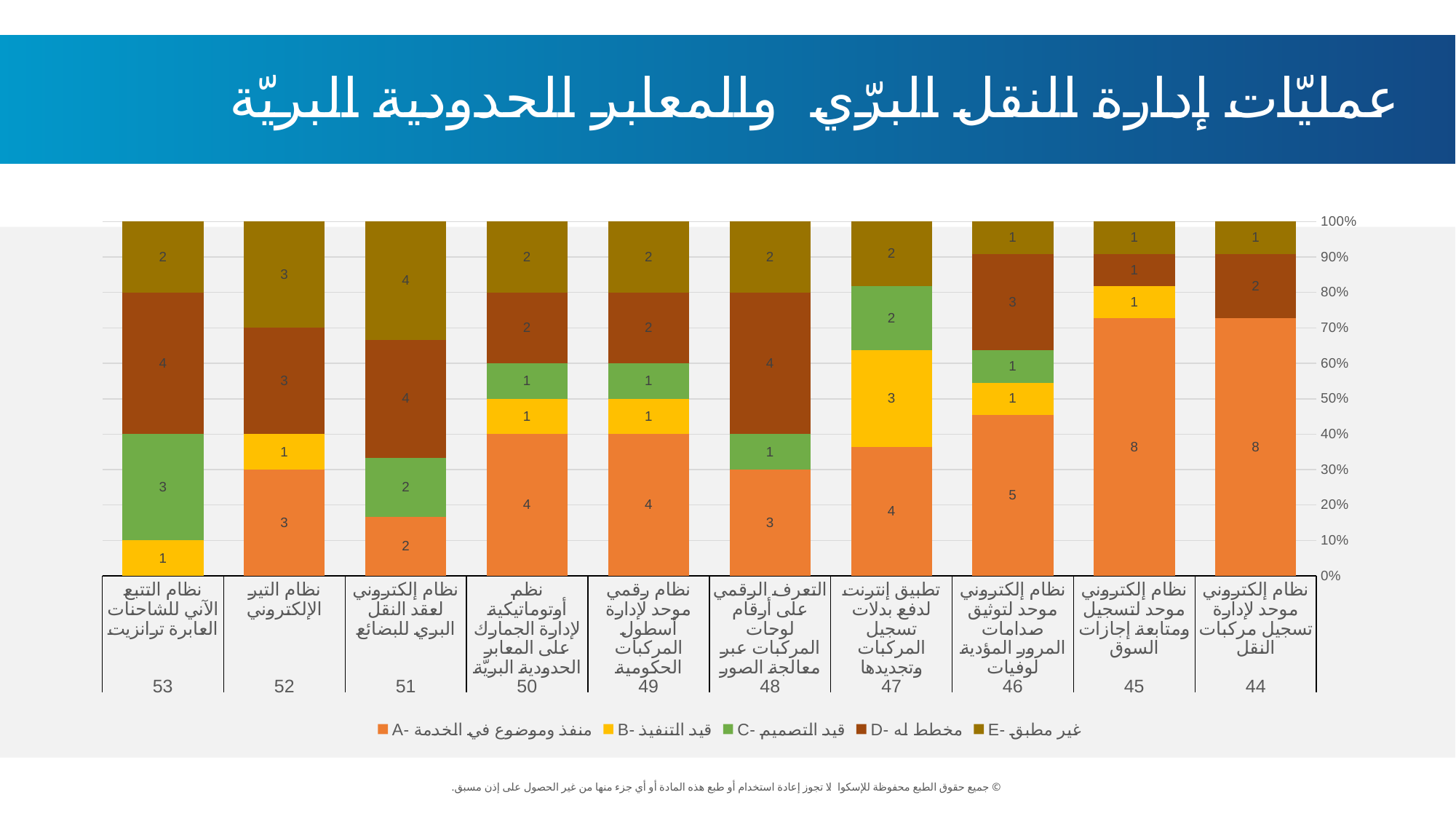
What is the value of series C (قيد التصميم) for category 53? 3 What is the value of series A (منفذ وموضوع في الخدمة) for category 46? 5 Which category has the highest value for series E (غير مطبق)? 51 What is the value of series B (قيد التنفيذ) for category 47? 3 What is the value of series E (غير مطبق) for category 51? 4 What is the total of all segments in the bar for category 51? 12 What kind of chart is shown on the slide? bar chart Is the top of the series A segment for category 44 greater or less than 70%? greater What is the difference between the series A value for category 45 and the series A value for category 51? 6 Which is larger: the series A value for category 46 or the series A value for category 52? category 46 How many categories (numbered bars) are shown on the x axis? 10 How many series does the legend list? 5